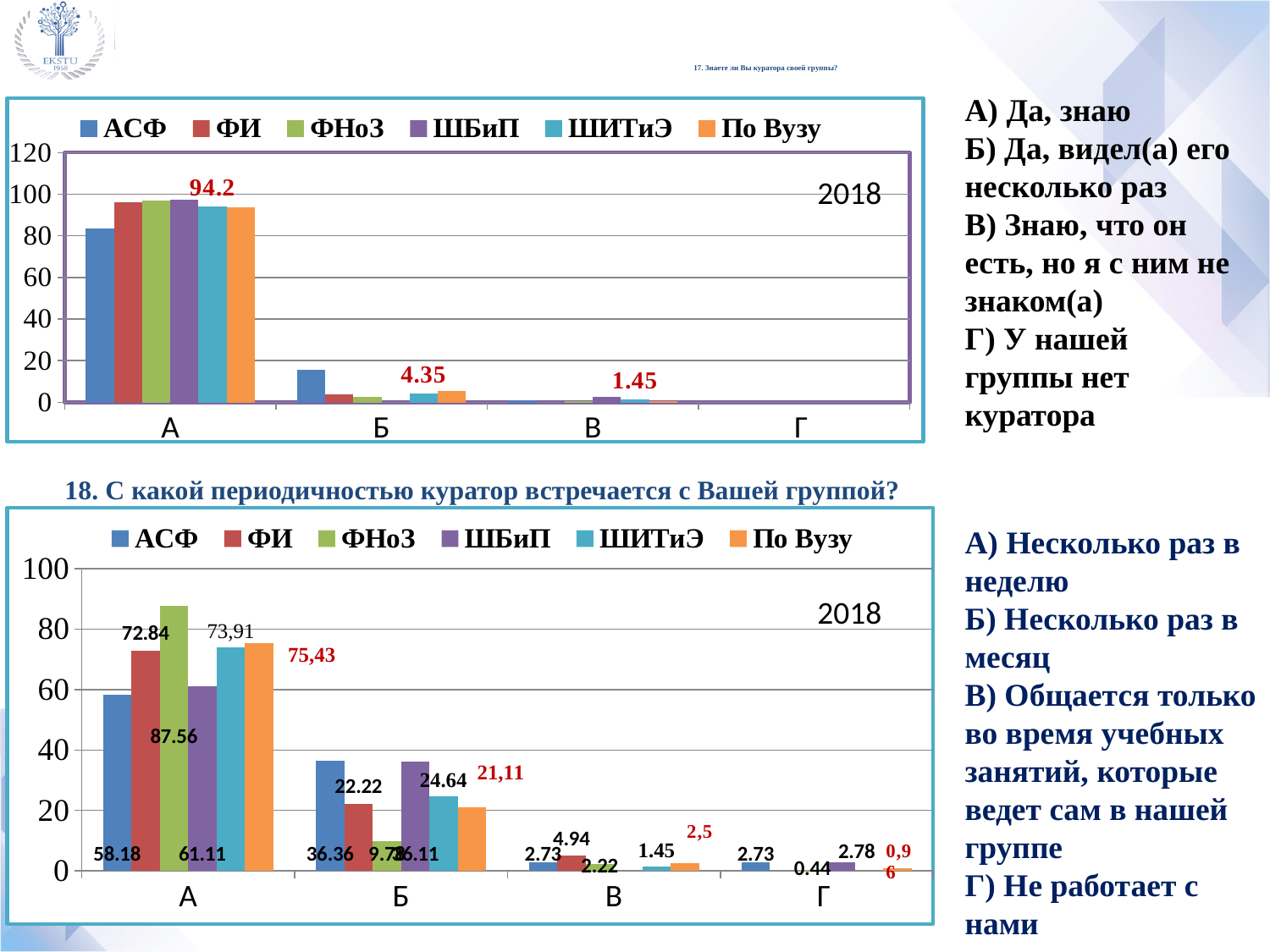
In the top chart, is the value for АСФ in category А greater or less than 100? less How many series does the legend of the top chart list? 6 In the bottom chart (question 18), what is the difference between the ФИ and АСФ values in category А? 14.66 How many categories are shown on the x axis of the bottom chart (question 18)? 4 In the bottom chart (question 18), which series has the highest value in category А? ФНоЗ In the bottom chart (question 18), which is larger in category Б: АСФ or ФИ? АСФ In the bottom chart (question 18), what is the value for ФНоЗ in category А? 87.56 In the top chart, which category has the highest values? А In the bottom chart (question 18), what is the value for По Вузу in category А? 75,43 What kind of chart is the top chart on the slide? bar chart